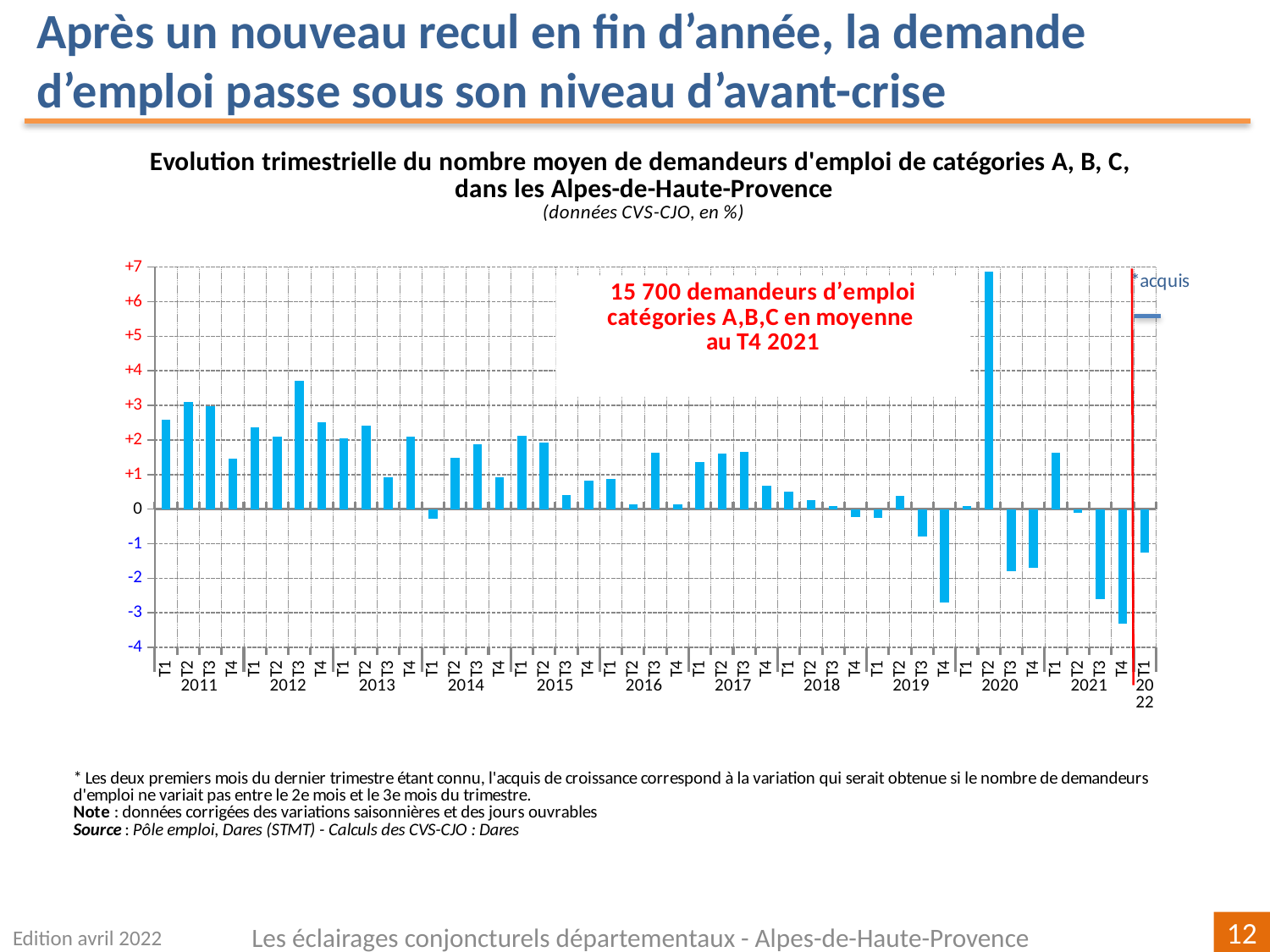
According to the annotation on the chart, how many demandeurs d'emploi catégories A,B,C were there on average in T4 2021? 15 700 Which is larger, the value for T2 2020 or the value for T3 2012? T2 2020 Is the value for T2 2020 greater or less than +6? greater Is the value for T3 2012 greater or less than +3? greater Which quarter has the highest value in the chart? T2 2020 Is the value for T4 2019 greater or less than -2? less What kind of chart is shown on the slide? bar chart Which is larger, the value for T2 2011 or the value for T1 2011? T2 2011 Which quarter has the lowest value in the chart? T4 2021 Do the values rise or fall from T1 2021 to T4 2021? fall How many quarterly bars are plotted in the chart? 45